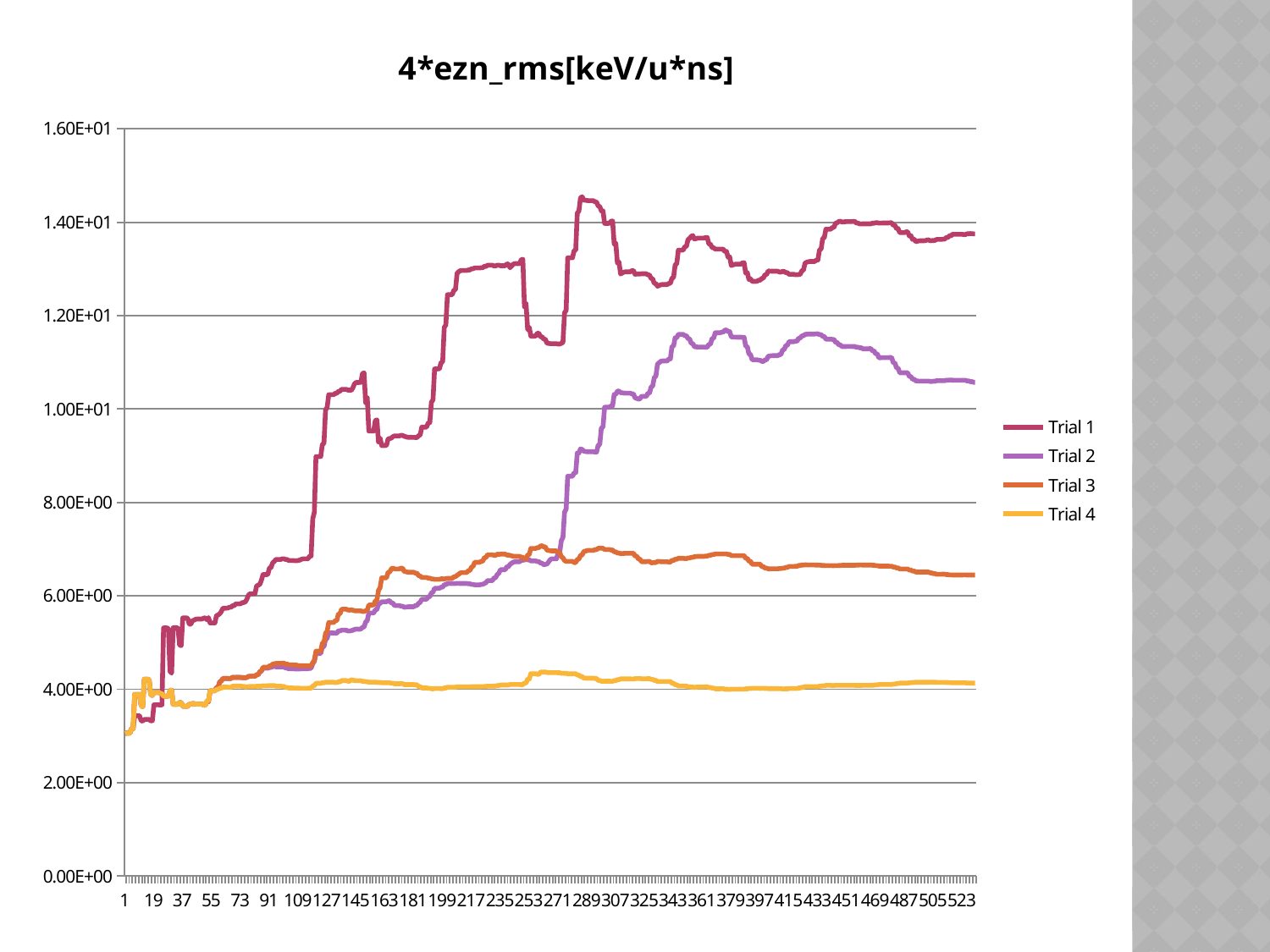
At the right end of the x axis, which is larger, Trial 1 or Trial 2? Trial 1 Which series has the lowest values across the chart? Trial 4 Which series has the highest values at the right end of the x axis? Trial 1 How many series does the legend list? 4 What is the maximum value shown on the y axis? 1.60E+01 Does Trial 1 generally rise or fall from the left to the right of the x axis? rise At the right end of the x axis, is the value for Trial 3 greater or less than 8.00E+00? less At the right end of the x axis, is the value for Trial 4 greater or less than 6.00E+00? less What is the title of the chart? 4*ezn_rms[keV/u*ns] What kind of chart is shown on the slide? line chart At the right end of the x axis, is the value for Trial 2 greater or less than 1.00E+01? greater